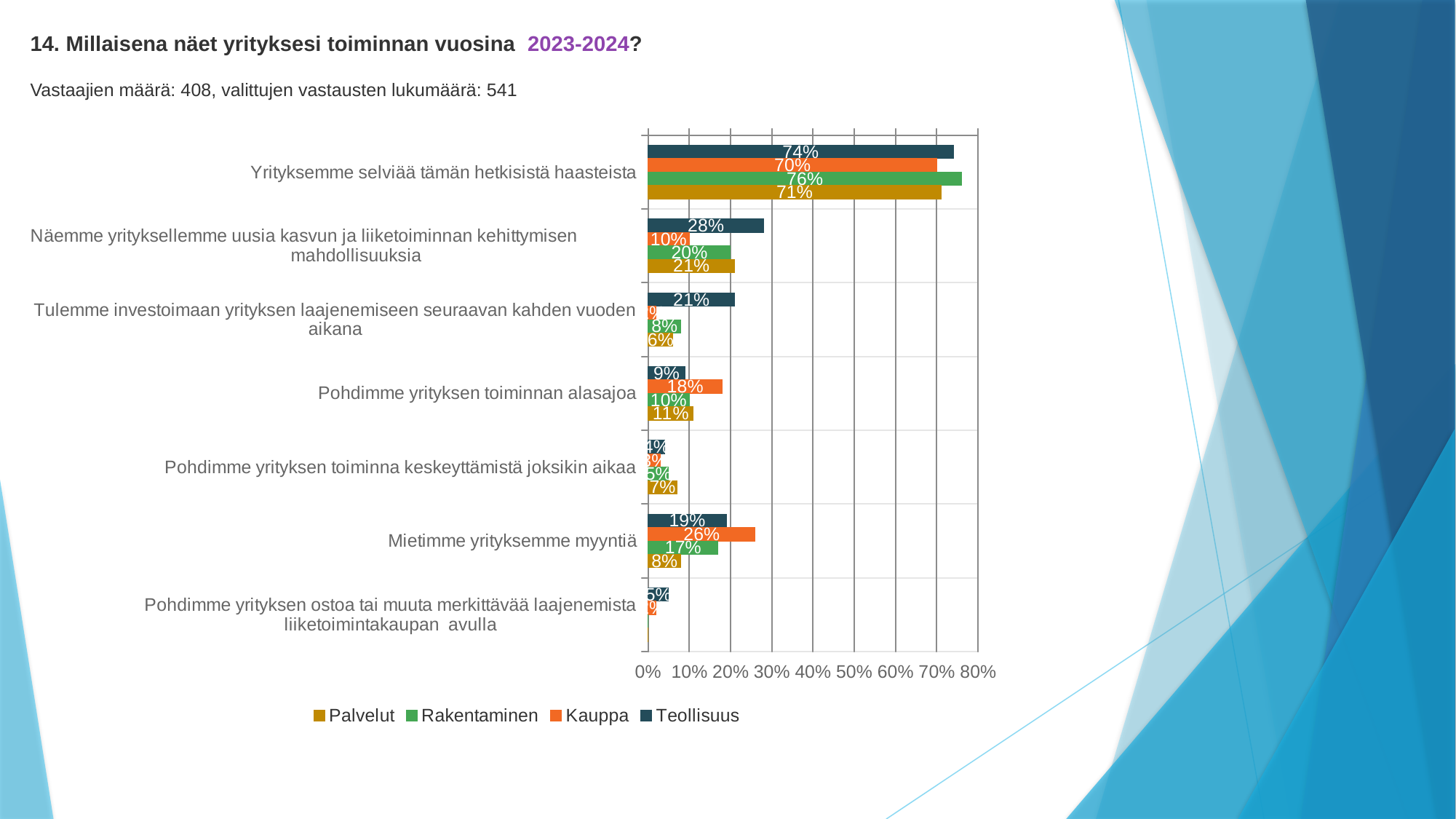
What is the value for Kauppa in the category "Mietimme yrityksemme myyntiä"? 26% What is the difference between the Teollisuus and Kauppa values in the category "Näemme yrityksellemme uusia kasvun ja liiketoiminnan kehittymisen mahdollisuuksia"? 18% What kind of chart is shown on the slide? Bar chart Which series has the highest value in the category "Yrityksemme selviää tämän hetkisistä haasteista"? Rakentaminen In the category "Pohdimme yrityksen toiminnan alasajoa", which is larger: the Kauppa value or the Teollisuus value? Kauppa What is the value for Teollisuus in the category "Näemme yrityksellemme uusia kasvun ja liiketoiminnan kehittymisen mahdollisuuksia"? 28% Is the Teollisuus value for "Tulemme investoimaan yrityksen laajenemiseen seuraavan kahden vuoden aikana" greater or less than 10%? greater What is the value for Palvelut in the category "Pohdimme yrityksen toiminnan alasajoa"? 11% What is the value for Rakentaminen in the category "Yrityksemme selviää tämän hetkisistä haasteista"? 76% How many categories are shown on the chart? 7 Which series has the lowest value in the category "Mietimme yrityksemme myyntiä"? Palvelut How many series does the legend list? 4